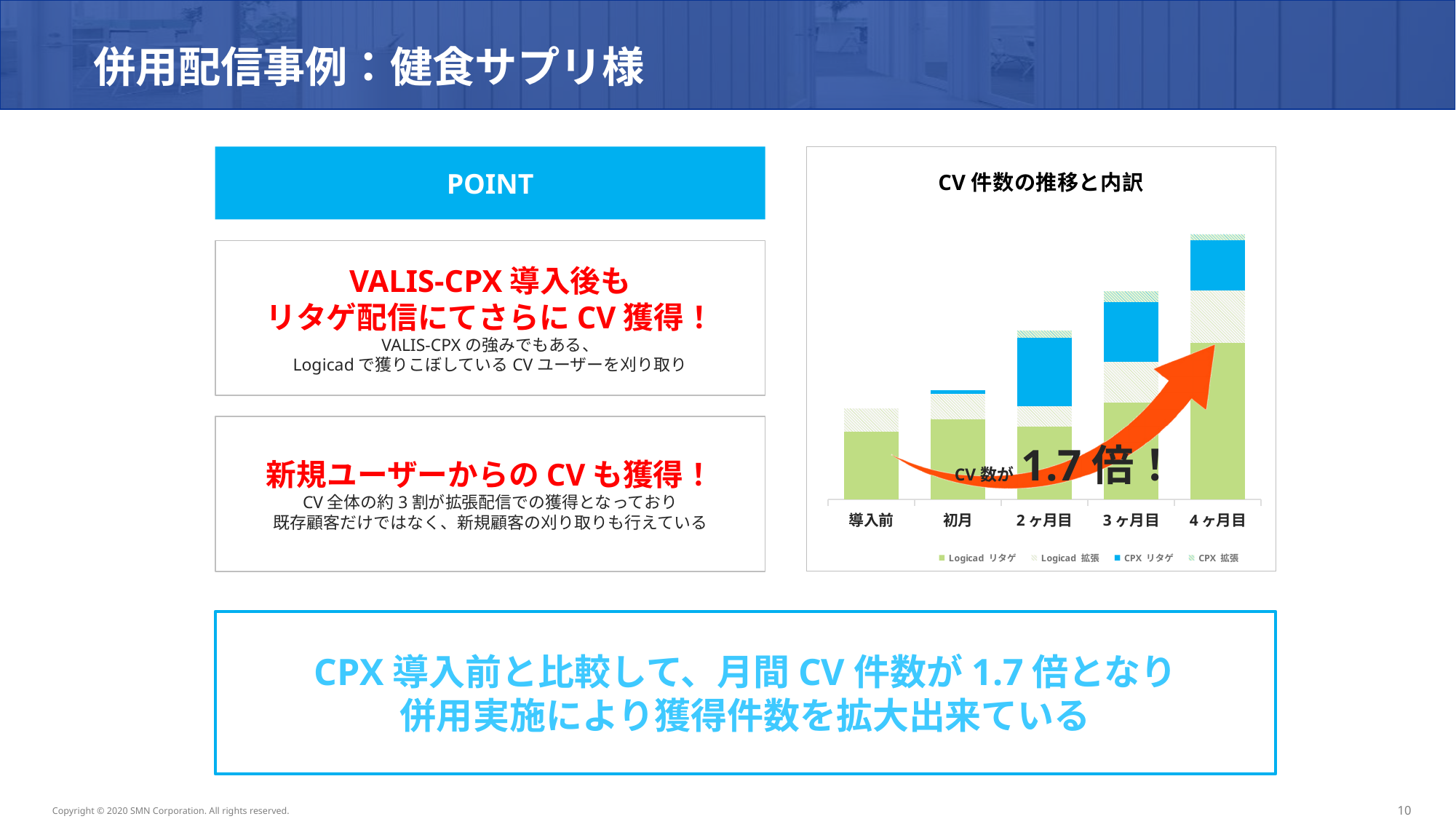
What is the title of the chart? CV件数の推移と内訳 Is the total stacked bar for 4ヶ月目 larger or smaller than the total for 導入前? larger Which category has the tallest stacked bar in the chart? 4ヶ月目 Do the total CV counts rise or fall from 導入前 to 4ヶ月目? rise How many series does the chart's legend list? 4 According to the annotation on the chart, by what factor did the CV count increase? 1.7倍 How many categories are shown on the x axis of the chart? 5 Which series forms the bottom segment of each stacked bar? Logicad リタゲ What kind of chart is shown on the slide? stacked bar chart Which category has the shortest stacked bar in the chart? 導入前 Is the total stacked bar for 3ヶ月目 larger or smaller than the total for 初月? larger